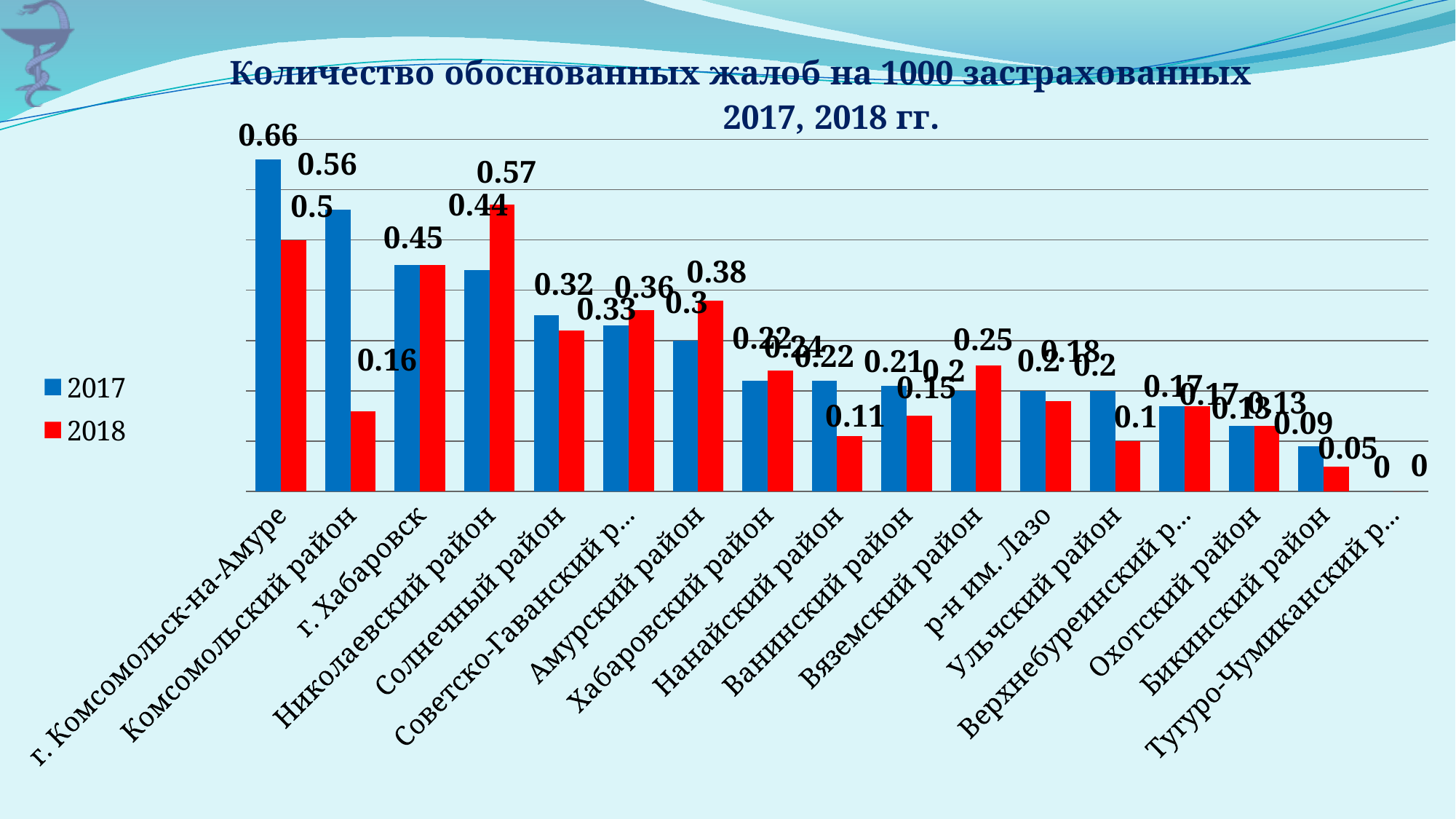
Which category has the lowest value for 2017? Тугуро-Чумиканский р... What is the value for Николаевский район in 2018? 0.57 Which category has the highest value for 2017? г. Комсомольск-на-Амуре How many series does the legend list? 2 What is the value for Комсомольский район in 2018? 0.16 What is the value for Бикинский район in 2018? 0.05 Which category has the highest value for 2018? Николаевский район What is the difference between the 2017 and 2018 values for г. Комсомольск-на-Амуре? 0.16 Which is larger for Нанайский район: the 2017 value or the 2018 value? 2017 What is the value for г. Комсомольск-на-Амуре in 2017? 0.66 What kind of chart is shown on the slide? Bar chart How many categories are shown on the x axis? 17